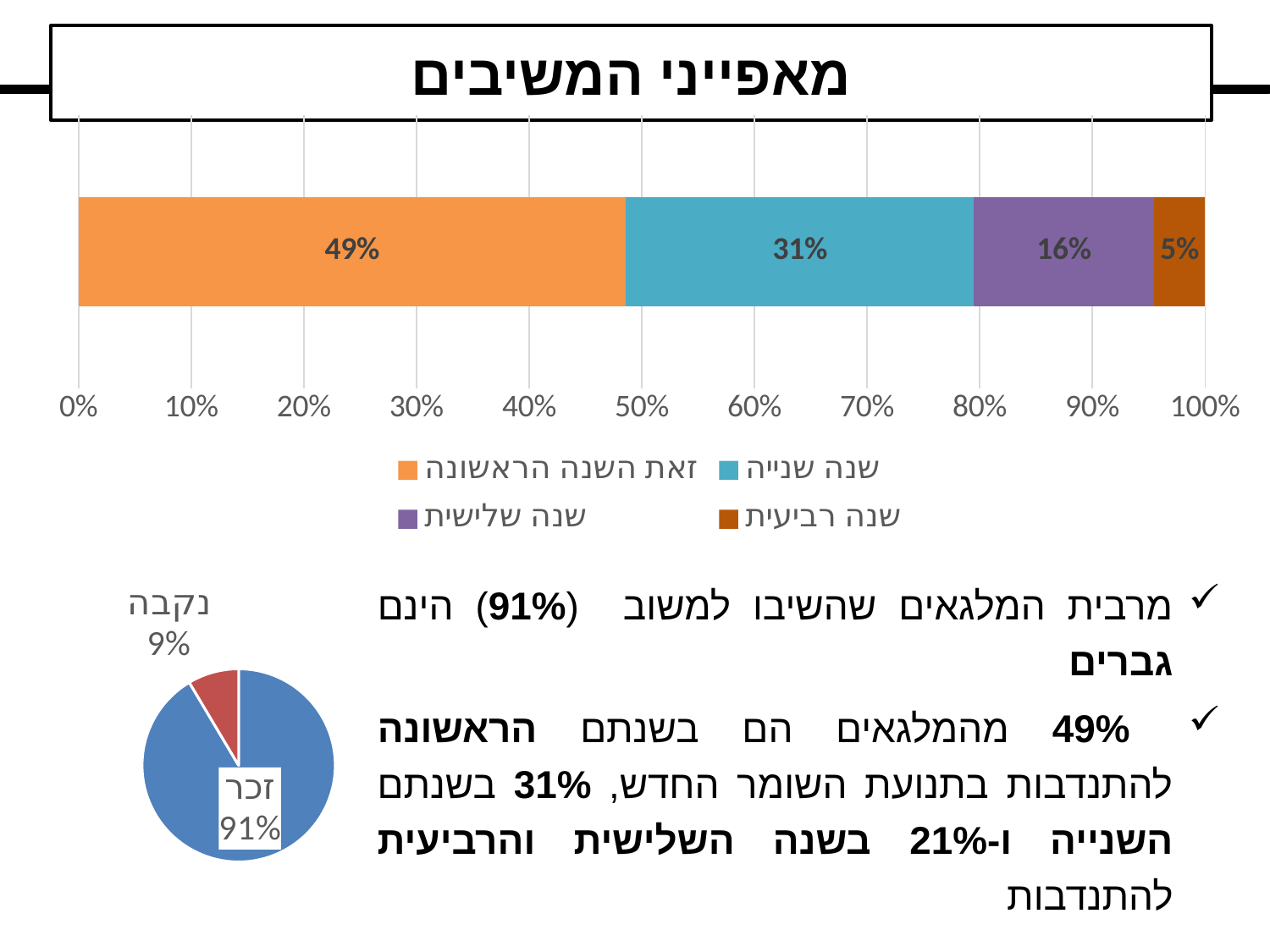
In the pie chart at the bottom left of the slide, which slice is larger, 'זכר' or 'נקבה'? זכר In the stacked bar chart at the top of the slide, what is the value for 'שנה שנייה'? 31% What kind of chart is shown at the top of the slide? Stacked bar chart In the stacked bar chart at the top of the slide, what is the value for 'שנה שלישית'? 16% In the stacked bar chart at the top of the slide, which series has the smallest segment? שנה רביעית In the stacked bar chart at the top of the slide, what is the value for 'שנה רביעית'? 5% In the stacked bar chart at the top of the slide, which series has the largest segment? זאת השנה הראשונה In the pie chart at the bottom left of the slide, what is the share for 'נקבה'? 9% In the pie chart at the bottom left of the slide, what is the share for 'זכר'? 91% In the stacked bar chart at the top of the slide, what is the value for 'זאת השנה הראשונה'? 49% In the stacked bar chart at the top of the slide, how many series does the legend list? 4 In the stacked bar chart at the top of the slide, what is the difference between the values for 'זאת השנה הראשונה' and 'שנה שנייה'? 18%